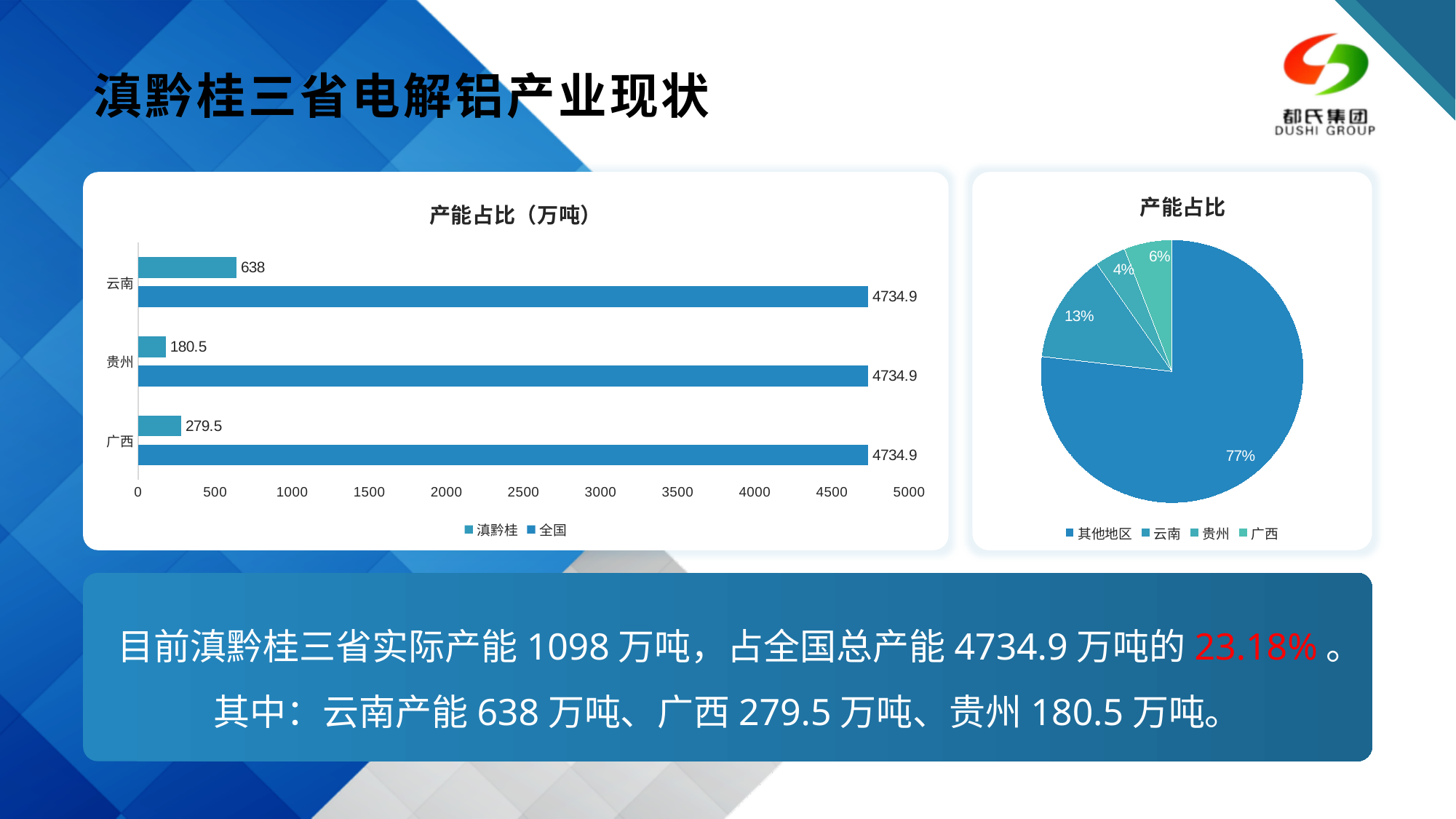
In the pie chart titled 产能占比, how many slices are there? 4 In the bar chart titled 产能占比（万吨）, is the 滇黔桂 value for 广西 larger or smaller than that for 贵州? larger In the bar chart titled 产能占比（万吨）, what is the 滇黔桂 value for 贵州? 180.5 In the bar chart titled 产能占比（万吨）, what is the 滇黔桂 value for 云南? 638 In the bar chart titled 产能占比（万吨）, what is the 全国 value for 广西? 4734.9 In the bar chart titled 产能占比（万吨）, which province has the highest 滇黔桂 value? 云南 In the bar chart titled 产能占比（万吨）, what is the difference between the 滇黔桂 values for 云南 and 广西? 358.5 In the pie chart titled 产能占比, what share does 云南 have? 13% In the bar chart titled 产能占比（万吨）, how many series does the legend list? 2 In the bar chart titled 产能占比（万吨）, which province has the lowest 滇黔桂 value? 贵州 What kind of chart is the left chart titled 产能占比（万吨）? bar chart In the pie chart titled 产能占比, what share does 其他地区 have? 77%